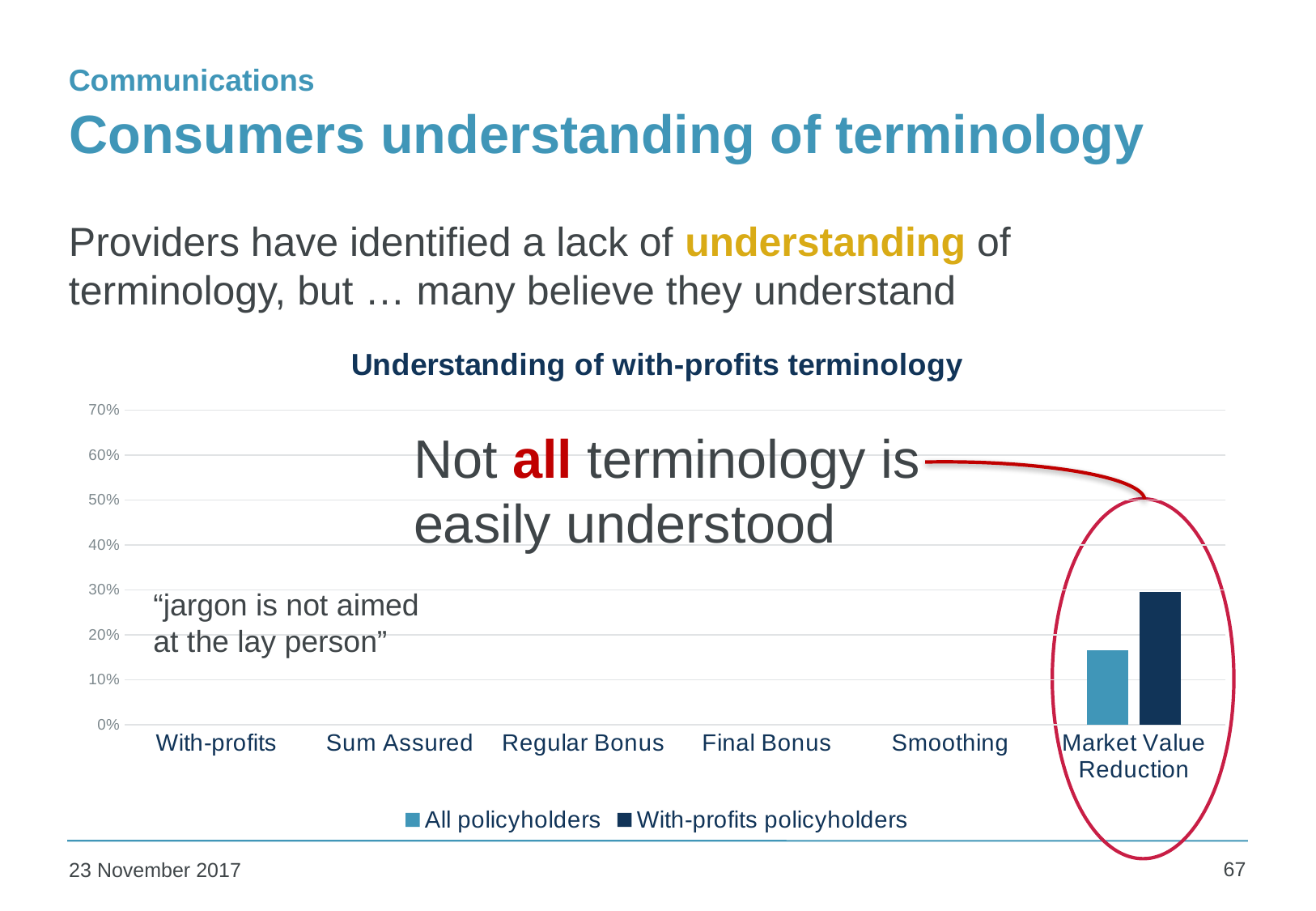
Is the value for With-profits policyholders in the Market Value Reduction category greater or less than 40%? less In the Market Value Reduction category, which series has the larger value: All policyholders or With-profits policyholders? With-profits policyholders What kind of chart is shown on the slide? bar chart Which series does the dark navy colour represent in the chart? With-profits policyholders Is the value for All policyholders in the Market Value Reduction category greater or less than 20%? less What is the title of the chart? Understanding of with-profits terminology How many series does the chart legend list? 2 How many categories are shown on the x axis of the chart? 6 Is the value for With-profits policyholders in the Market Value Reduction category greater or less than 20%? greater What is the highest value shown on the y axis of the chart? 70%